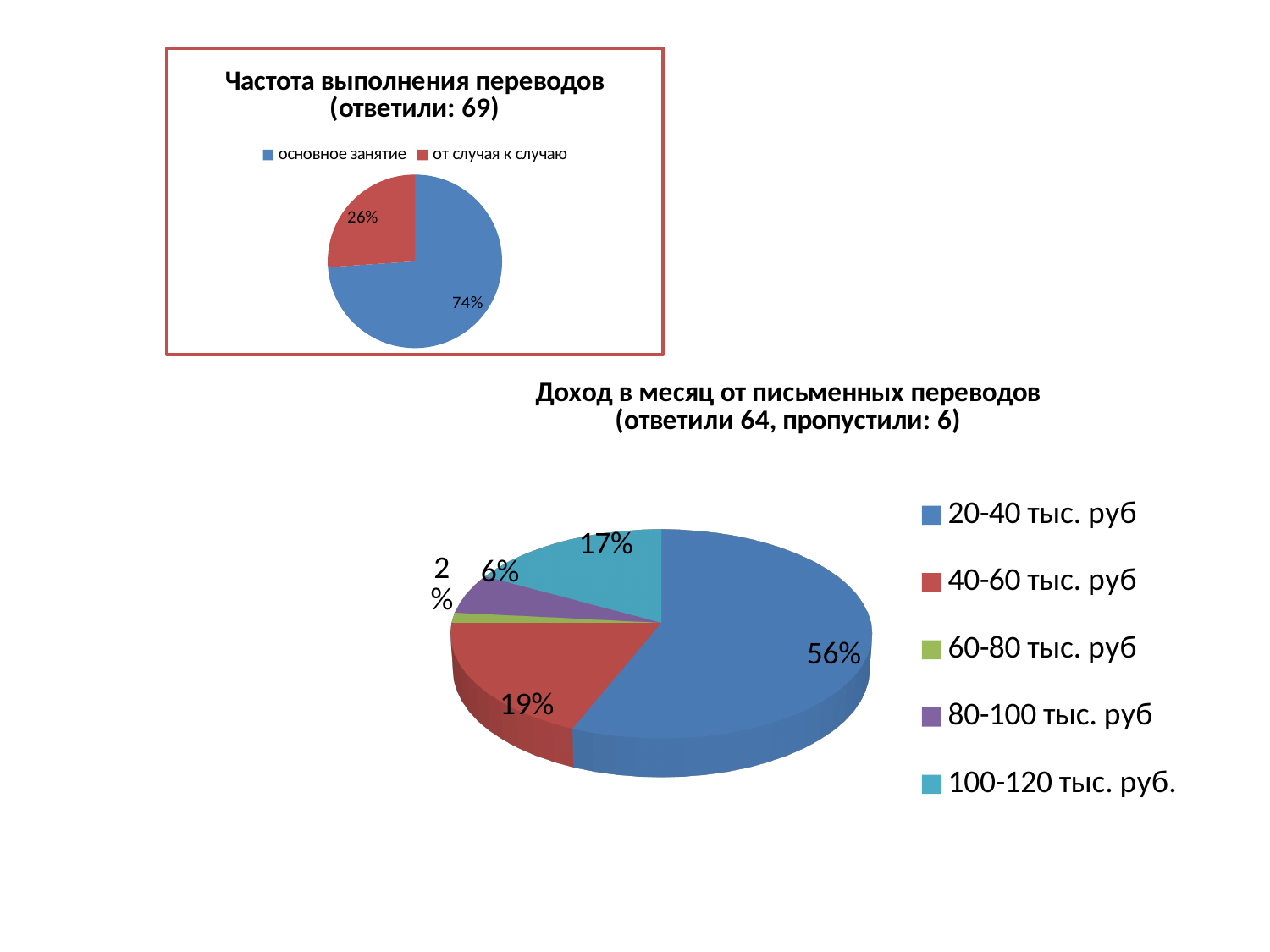
In the chart 'Доход в месяц от письменных переводов', what share is labelled for '20-40 тыс. руб'? 56% In the chart 'Частота выполнения переводов', which category has the larger slice? основное занятие In the chart 'Доход в месяц от письменных переводов', which category has the largest slice? 20-40 тыс. руб In the chart 'Доход в месяц от письменных переводов', what is the difference in percentage points between '40-60 тыс. руб' and '100-120 тыс. руб.'? 2 In the chart 'Доход в месяц от письменных переводов', what share is labelled for '100-120 тыс. руб.'? 17% What type of chart is the top chart 'Частота выполнения переводов'? pie chart In the chart 'Частота выполнения переводов', what is the difference in percentage points between 'основное занятие' and 'от случая к случаю'? 48 In the chart 'Доход в месяц от письменных переводов', which is larger: the slice for '40-60 тыс. руб' or the slice for '80-100 тыс. руб'? 40-60 тыс. руб In the chart 'Доход в месяц от письменных переводов', which category has the smallest slice? 60-80 тыс. руб In the chart 'Частота выполнения переводов', what share is labelled for 'от случая к случаю'? 26% In the chart 'Доход в месяц от письменных переводов', how many categories does the legend list? 5